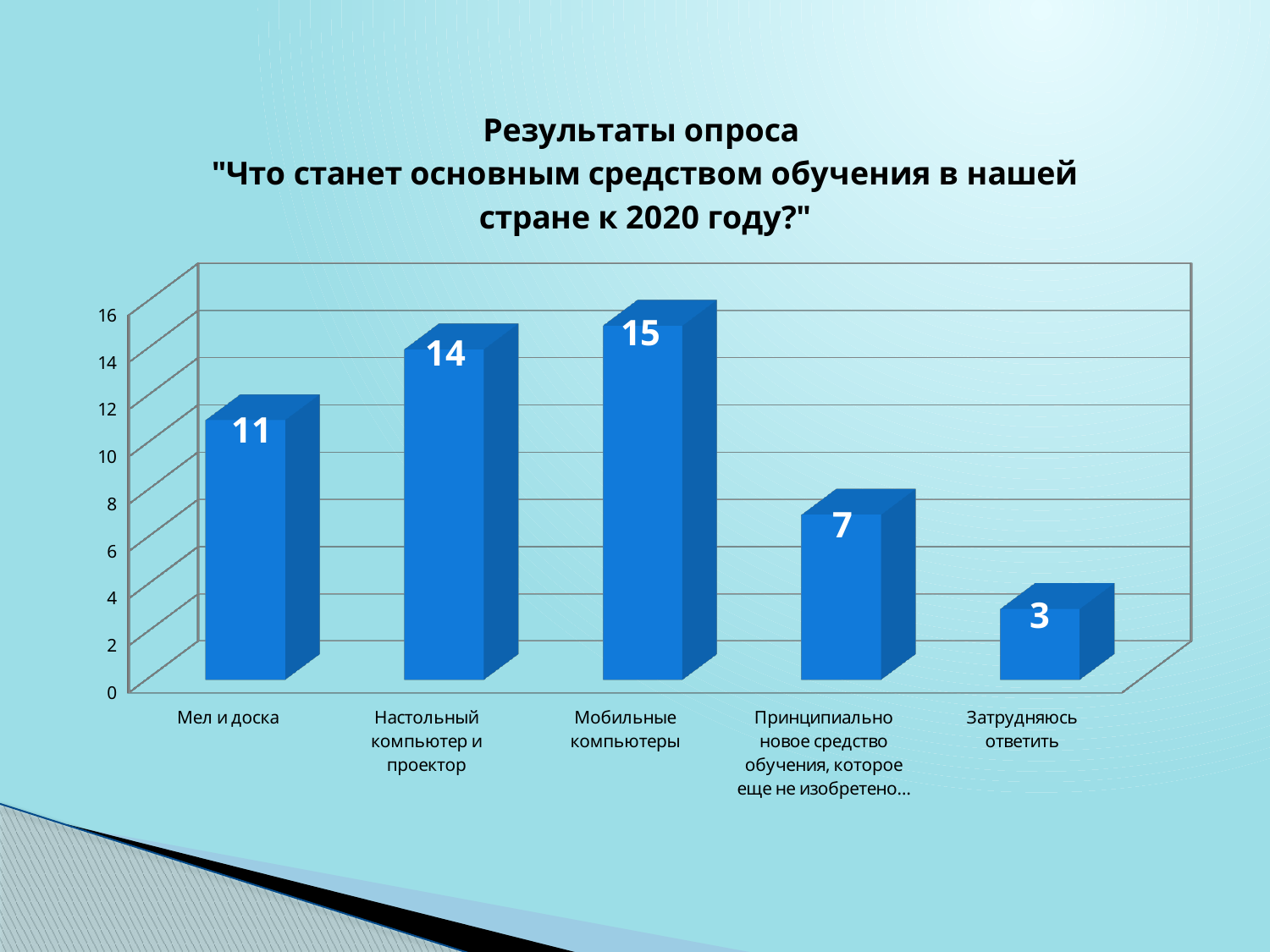
What is the value for Настольный компьютер и проектор? 14 What is the value for Мобильные компьютеры? 15 Which category has the highest value? Мобильные компьютеры Which category has the lowest value? Затрудняюсь ответить What is the maximum value shown on the vertical axis? 16 How many categories are shown on the chart? 5 What is the value for Затрудняюсь ответить? 3 What is the difference between the values for Настольный компьютер и проектор and Затрудняюсь ответить? 11 What is the difference between the values for Мобильные компьютеры and Мел и доска? 4 Which is larger: the value for Мел и доска or the value for Принципиально новое средство обучения, которое еще не изобретено...? Мел и доска What is the value for Мел и доска? 11 What kind of chart is shown on the slide? Bar chart